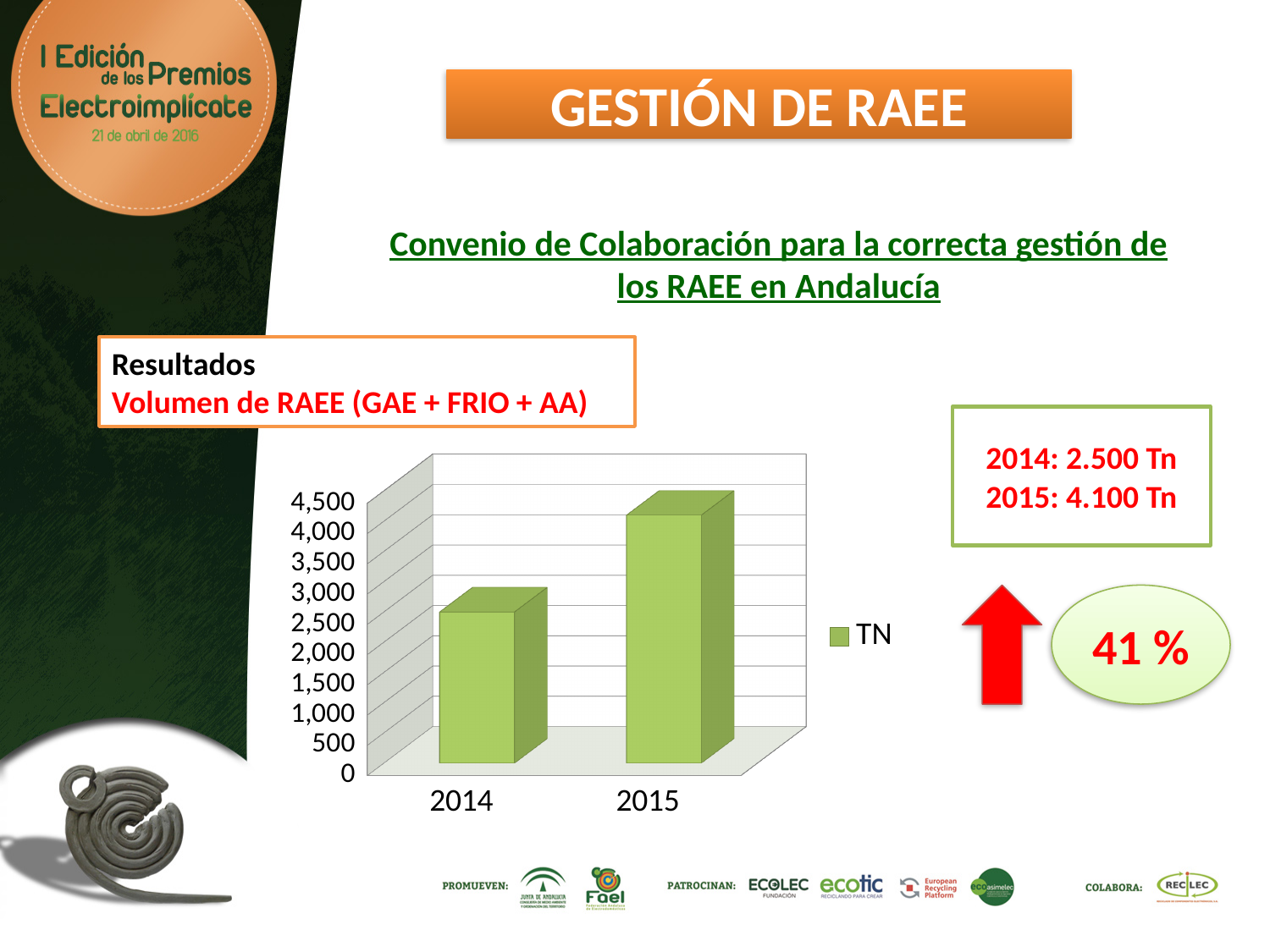
Which is larger, the value for 2014 or the value for 2015? 2015 Is the value for 2015 greater or less than 4,000? greater What is the difference between the 2015 and 2014 volumes of RAEE? 1.600 Tn What is the volume of RAEE for 2015? 4.100 Tn What kind of chart is shown on the slide? bar chart What is the name of the series shown in the chart legend? TN Which year has the highest bar in the chart? 2015 How many series does the chart legend list? 1 How many categories are plotted on the x axis of the chart? 2 Which year has the lowest bar in the chart? 2014 What is the volume of RAEE for 2014? 2.500 Tn Do the values rise or fall from 2014 to 2015? rise